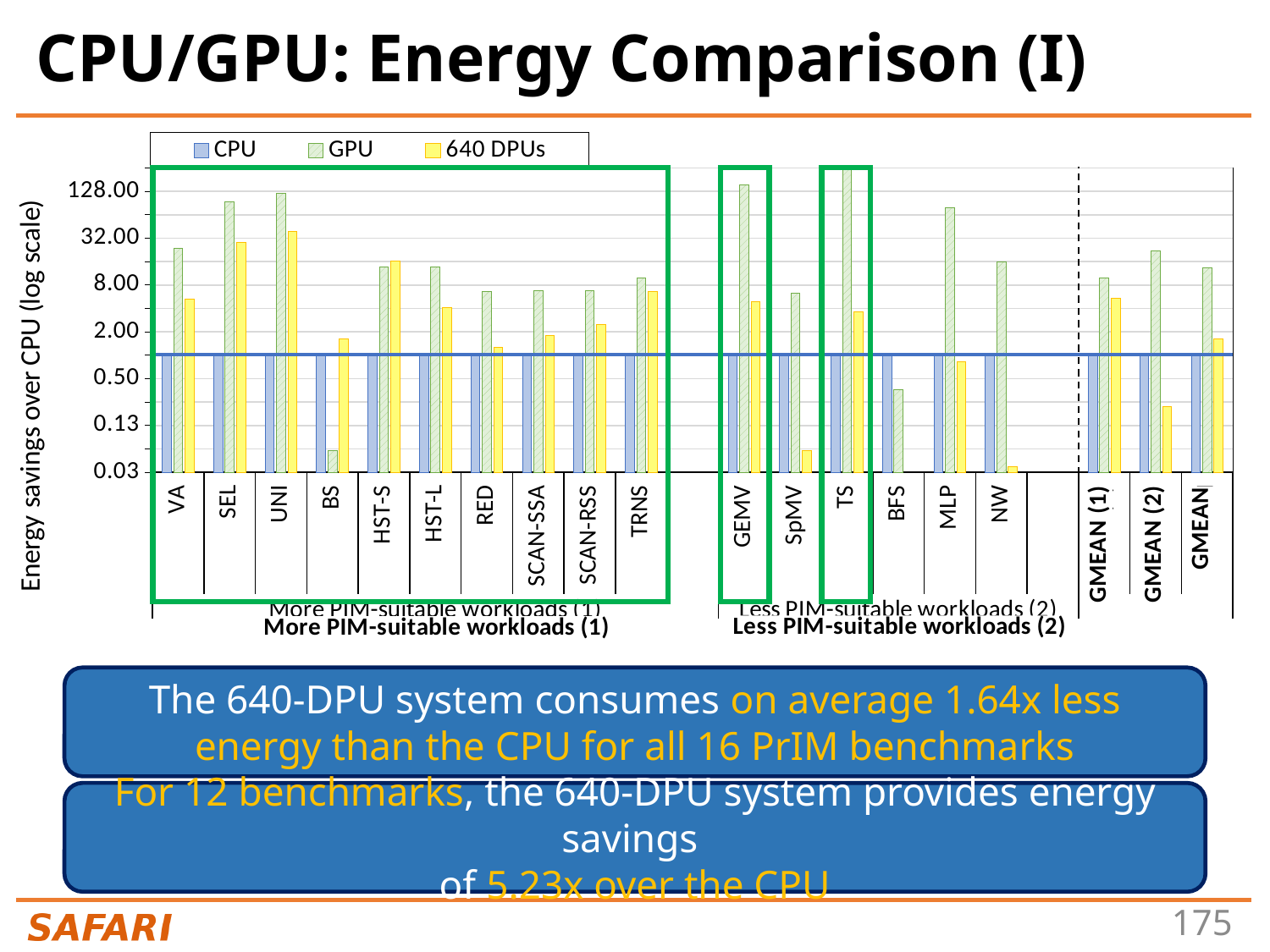
Is the GPU value for UNI greater or less than 32.00? greater For BS, which is larger: the GPU value or the 640 DPUs value? 640 DPUs How many categories are shown along the x axis? 19 For SEL, which is larger: the GPU value or the 640 DPUs value? GPU What kind of chart is shown on the slide? bar chart Is the 640 DPUs value for NW greater or less than 0.13? less Is the 640 DPUs value for GMEAN (2) greater or less than 0.50? less How many series does the legend list? 3 What is the label of the y axis? Energy savings over CPU (log scale) What are the three series listed in the legend? CPU, GPU, 640 DPUs